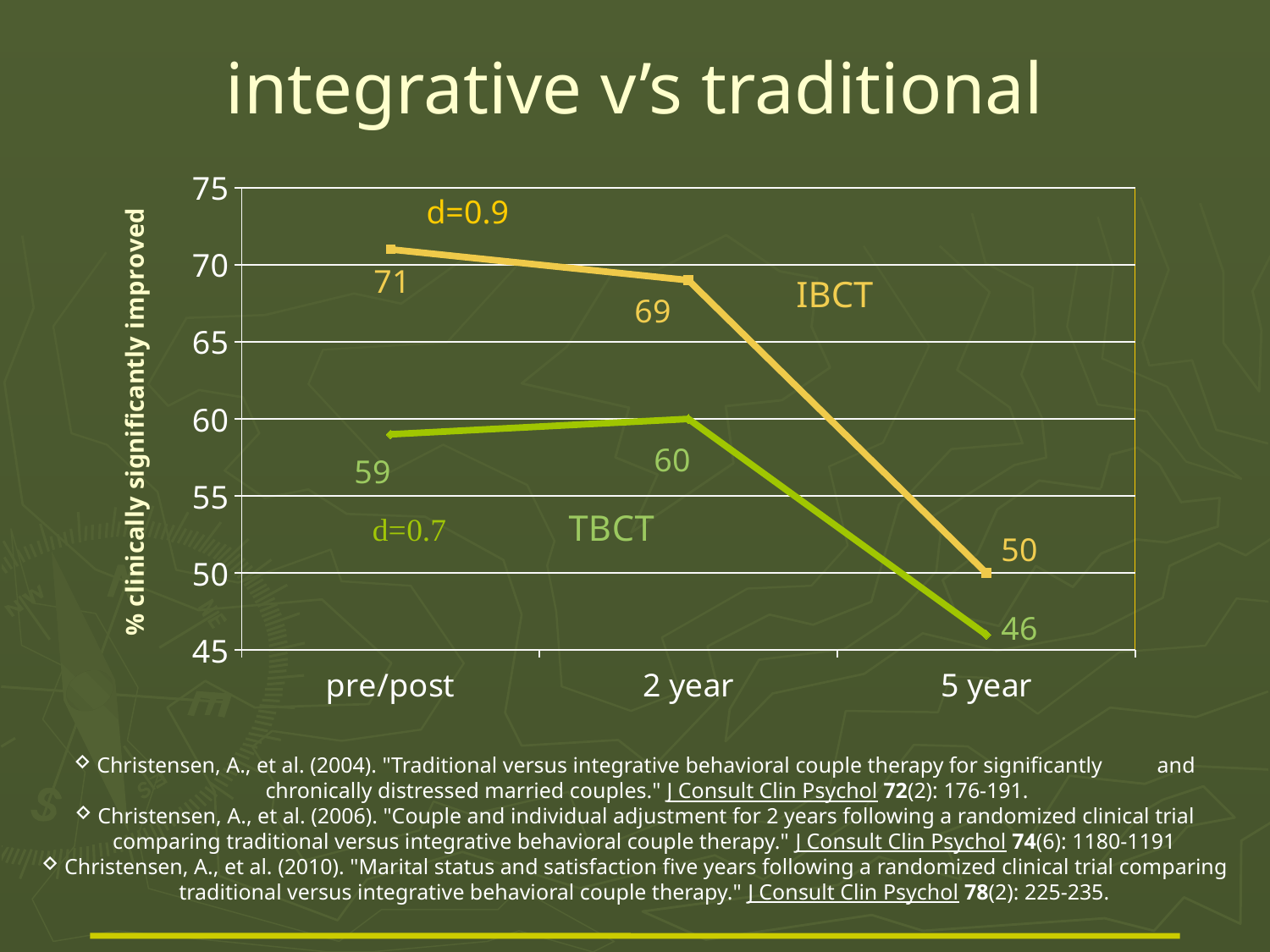
What is the IBCT value at pre/post? 71 What is the TBCT value at pre/post? 59 At which time point is the TBCT value highest? 2 year What is the difference between the IBCT and TBCT values at pre/post? 12 What is the TBCT value at 5 year? 46 Which is larger at 5 year, IBCT or TBCT? IBCT How many time points are shown on the x axis? 3 What is the IBCT value at 2 year? 69 What kind of chart is shown on the slide? line chart What is the y-axis label of the chart? % clinically significantly improved What is the difference between the IBCT value at 2 year and at 5 year? 19 At which time point is the IBCT value lowest? 5 year